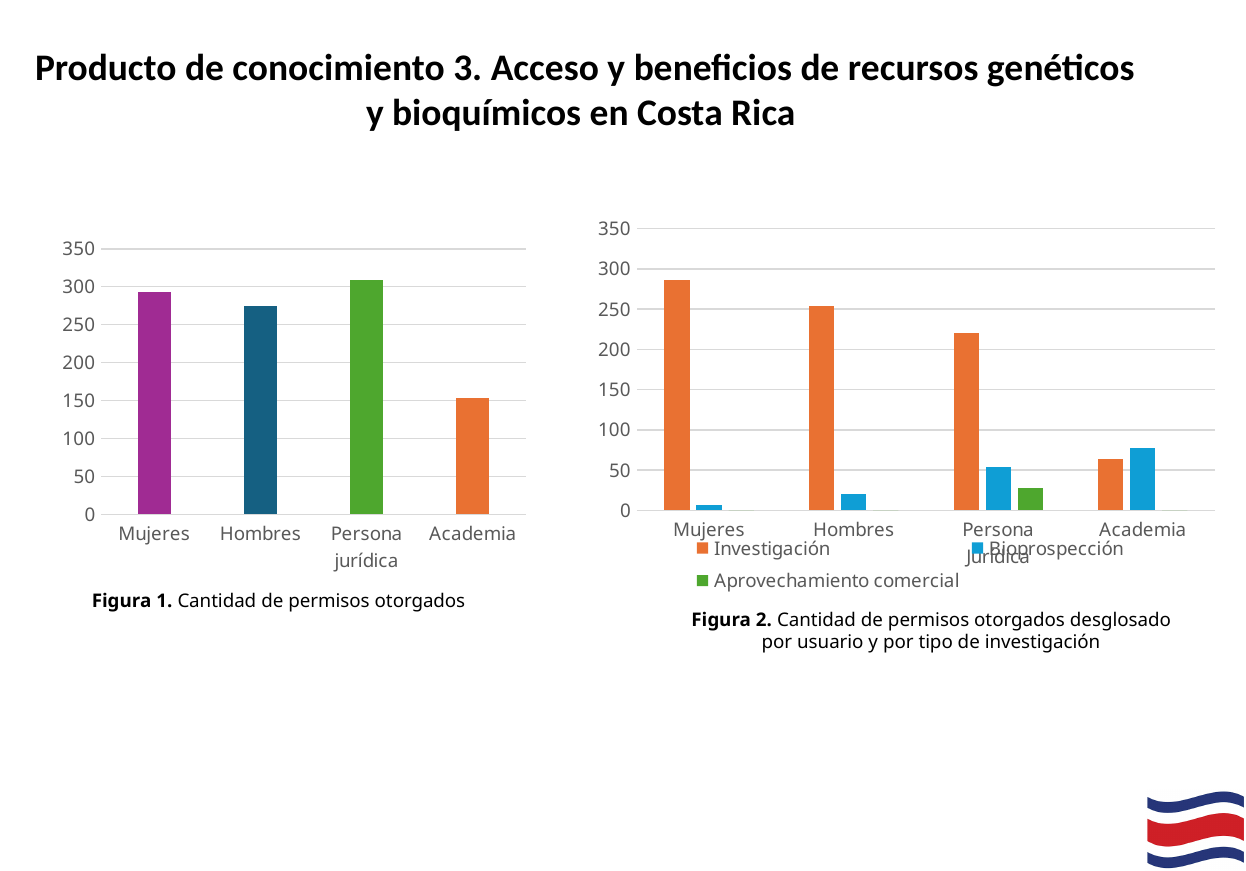
In Figura 2, how many series does the legend list? 3 In Figura 1, is the value for Persona jurídica greater or less than 300? greater In Figura 2, which series is shown in green? Aprovechamiento comercial In Figura 2, which is larger for Persona jurídica: Bioprospección or Aprovechamiento comercial? Bioprospección In Figura 1, how many categories are shown on the x axis? 4 In Figura 2, which category has the highest Bioprospección value? Academia In Figura 2, is the Investigación value for Academia greater or less than 100? less In Figura 1, which category has the highest value? Persona jurídica In Figura 1, which category has the lowest value? Academia In Figura 2, which category has the highest Investigación value? Mujeres In Figura 1, is the value for Academia greater or less than 200? less In Figura 1, what kind of chart is shown? bar chart